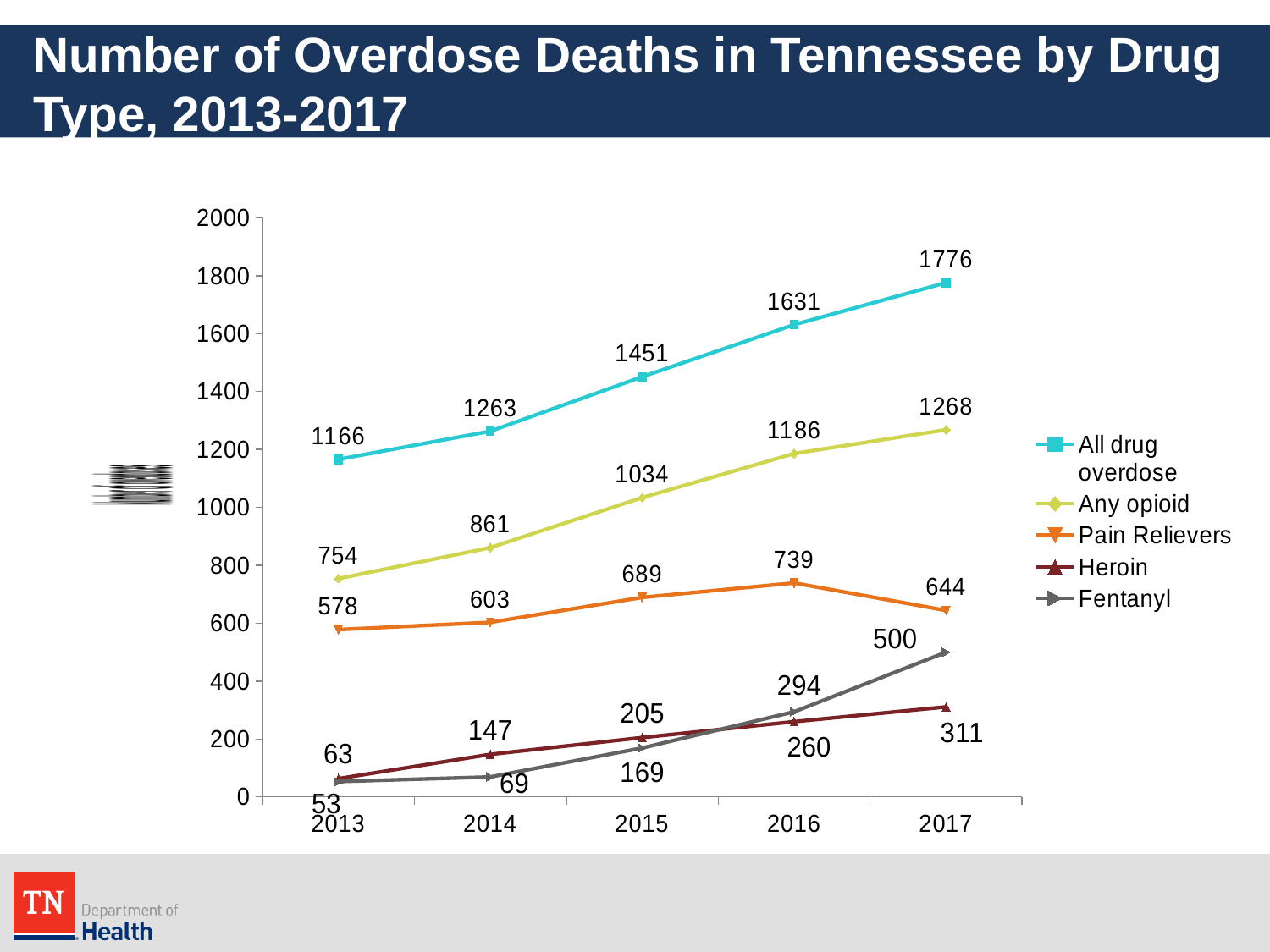
What type of chart is shown on the slide? line chart By how much did all drug overdose deaths increase from 2013 to 2017? 610 In which year were Pain Relievers overdose deaths highest? 2016 In which year were Heroin overdose deaths lowest? 2013 How many series does the legend list? 5 What was the number of Fentanyl overdose deaths in 2017? 500 How many years are shown on the x axis? 5 Do Fentanyl overdose deaths rise or fall from 2013 to 2017? rise What was the number of Any opioid overdose deaths in 2015? 1034 What is the difference between Any opioid deaths and Pain Relievers deaths in 2017? 624 Which was larger in 2016, Heroin deaths or Fentanyl deaths? Fentanyl What was the number of all drug overdose deaths in 2017? 1776